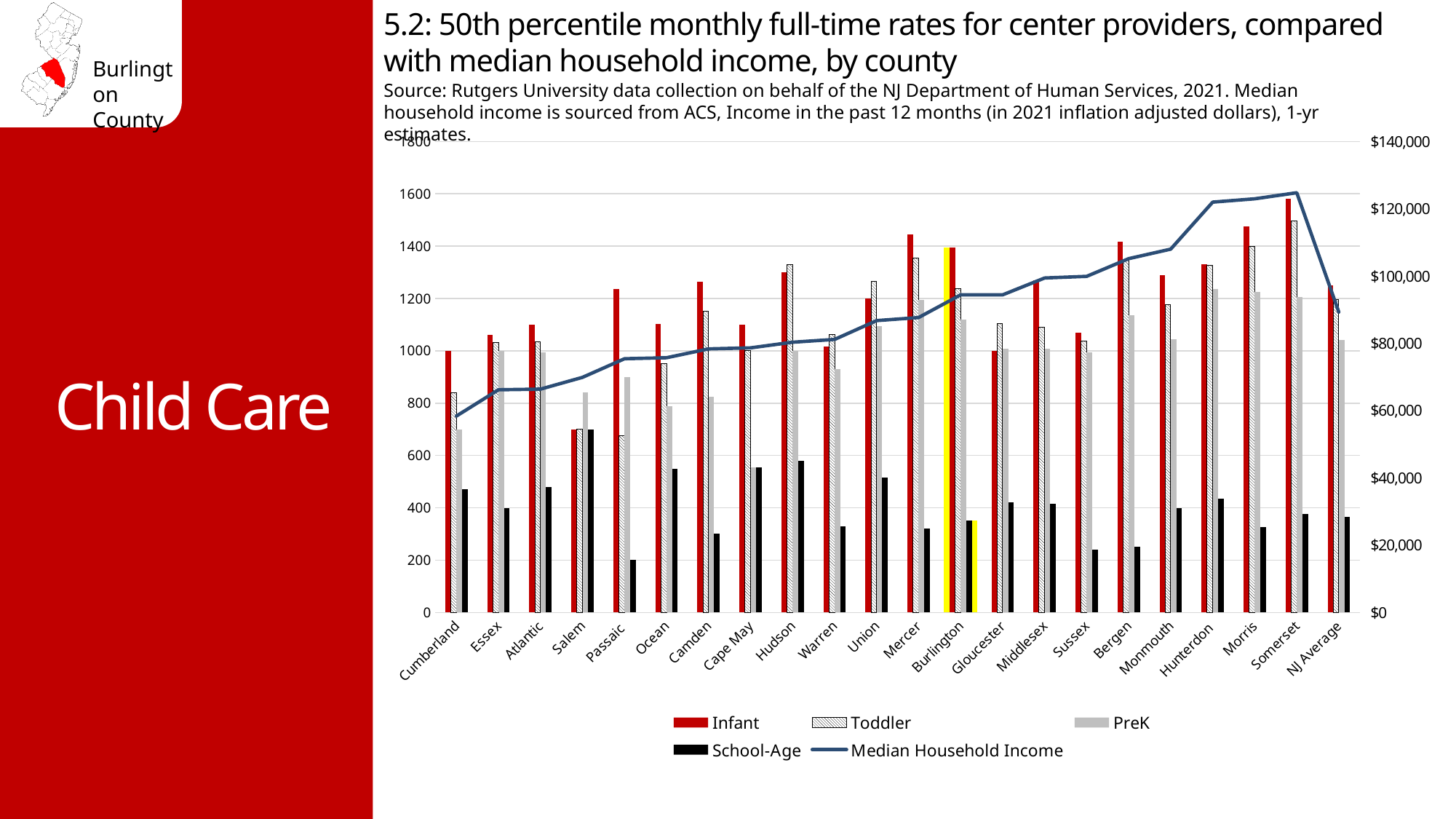
Which county has the lowest School-Age rate? Passaic How many series does the chart legend list? 5 Does the Median Household Income line generally rise or fall from Cumberland to Somerset? rise What type of chart is shown on the slide? Bar chart with a line Which is larger, the Toddler rate for Hudson or the Toddler rate for Cumberland? Hudson Which county has the lowest Infant rate? Salem Is the Infant rate for Somerset greater or less than 1400? greater Which county has the highest School-Age rate? Salem Which county has the highest Infant rate? Somerset How many categories are shown along the x axis of the chart? 22 Is the School-Age rate for Passaic greater or less than 400? less Which county has the lowest Median Household Income? Cumberland